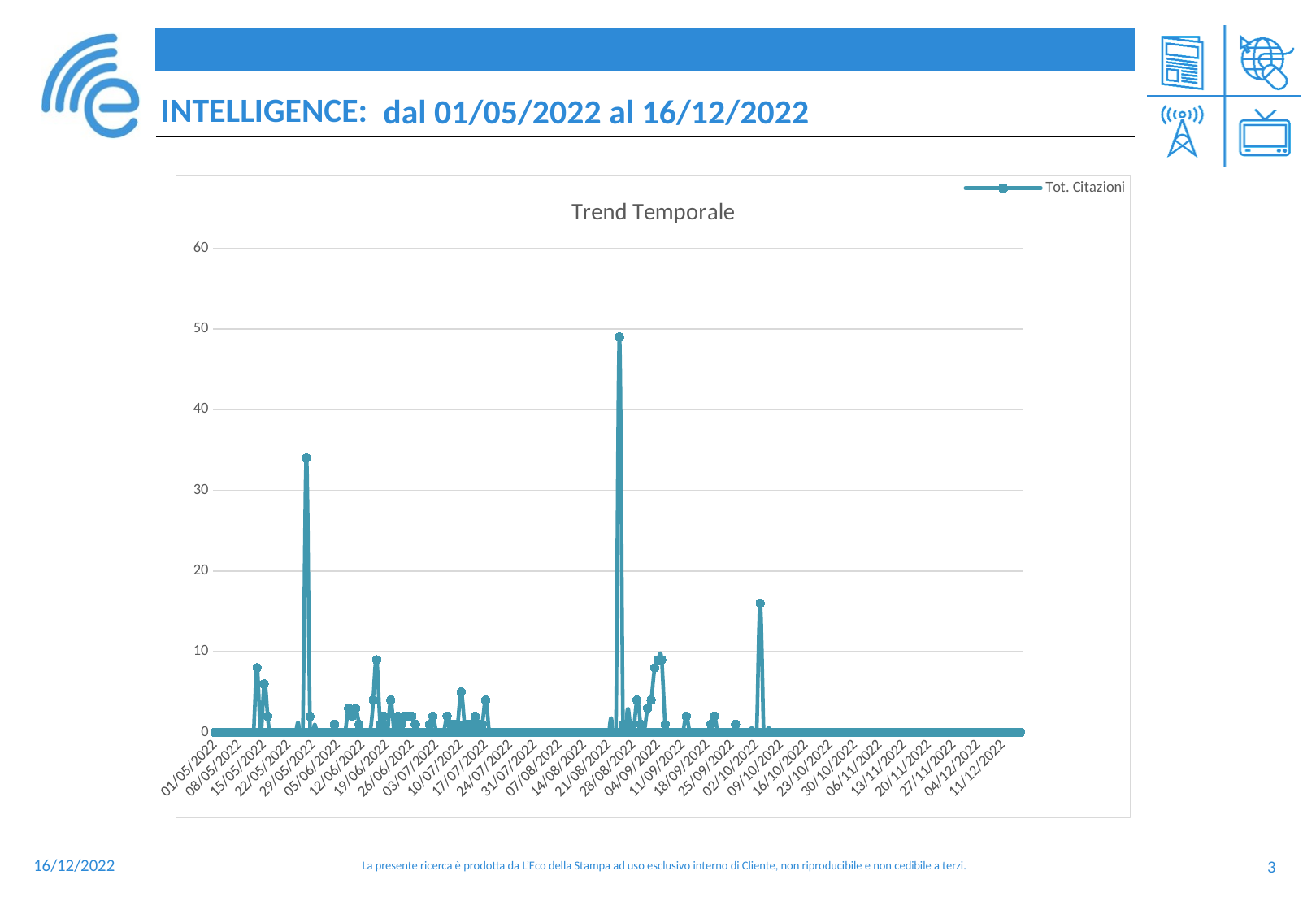
What kind of chart is shown on the slide? line chart Is the value for 11/12/2022 greater or less than 10? less Which is larger: the peak near 28/08/2022 or the peak near 29/05/2022? the peak near 28/08/2022 Is the peak value near 02/10/2022 greater or less than 20? less What is the title of the chart? Trend Temporale What is the maximum value shown on the vertical axis? 60 Is the peak value near 02/10/2022 greater or less than 10? greater How many series does the legend list? 1 What is the name of the series shown in the legend? Tot. Citazioni